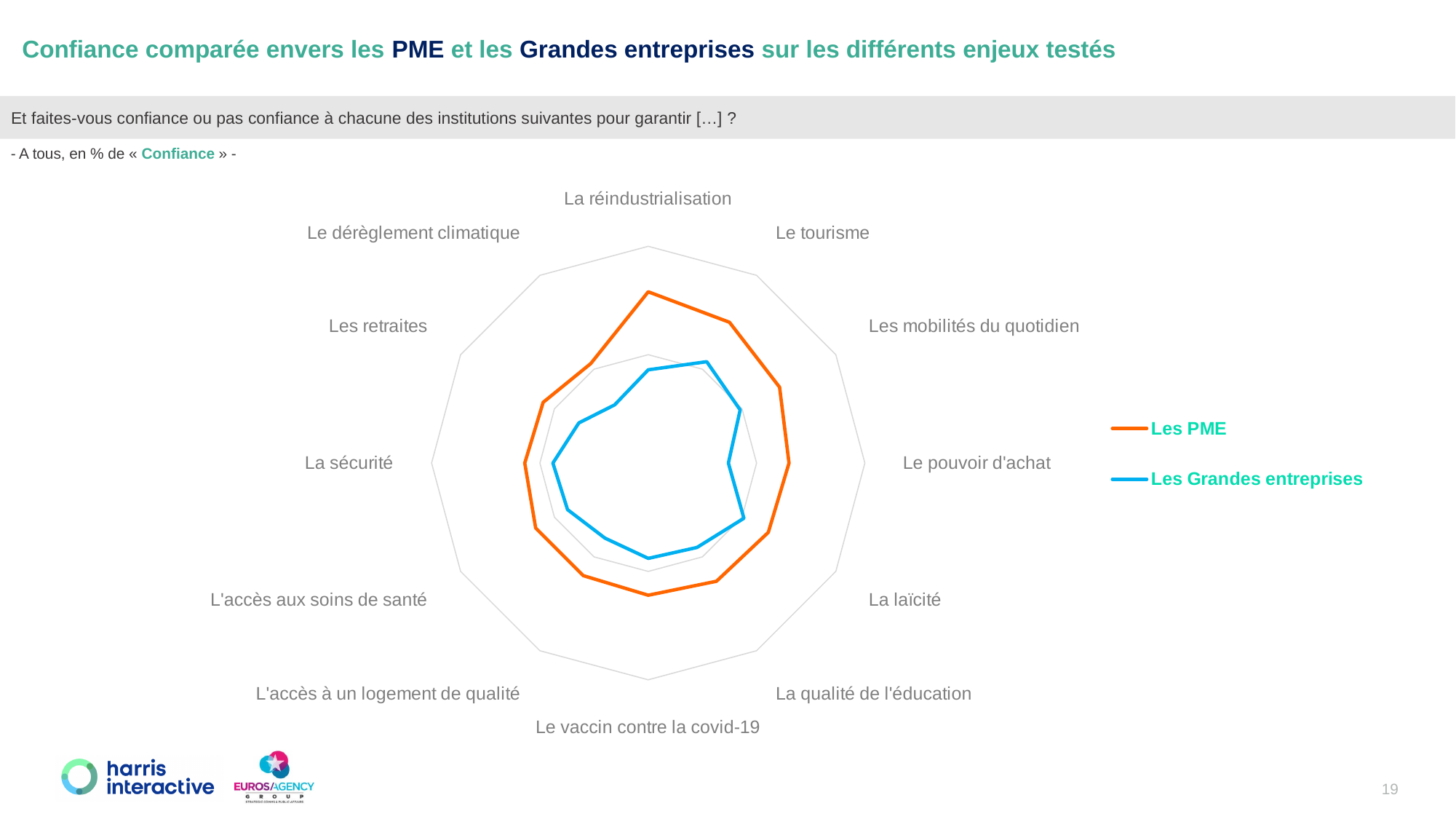
What kind of chart is shown on the slide? Radar chart For the series 'Les PME', which category has the highest value? La réindustrialisation For 'Le pouvoir d'achat', which series has the higher value: Les PME or Les Grandes entreprises? Les PME Does the 'Les PME' line lie outside the 'Les Grandes entreprises' line for every category? Yes Which series is shown in blue in the legend? Les Grandes entreprises For 'La réindustrialisation', which series has the higher value: Les PME or Les Grandes entreprises? Les PME How many categories (enjeux) are plotted on the radar chart? 12 Which series is shown in orange in the legend? Les PME How many series does the legend list? 2